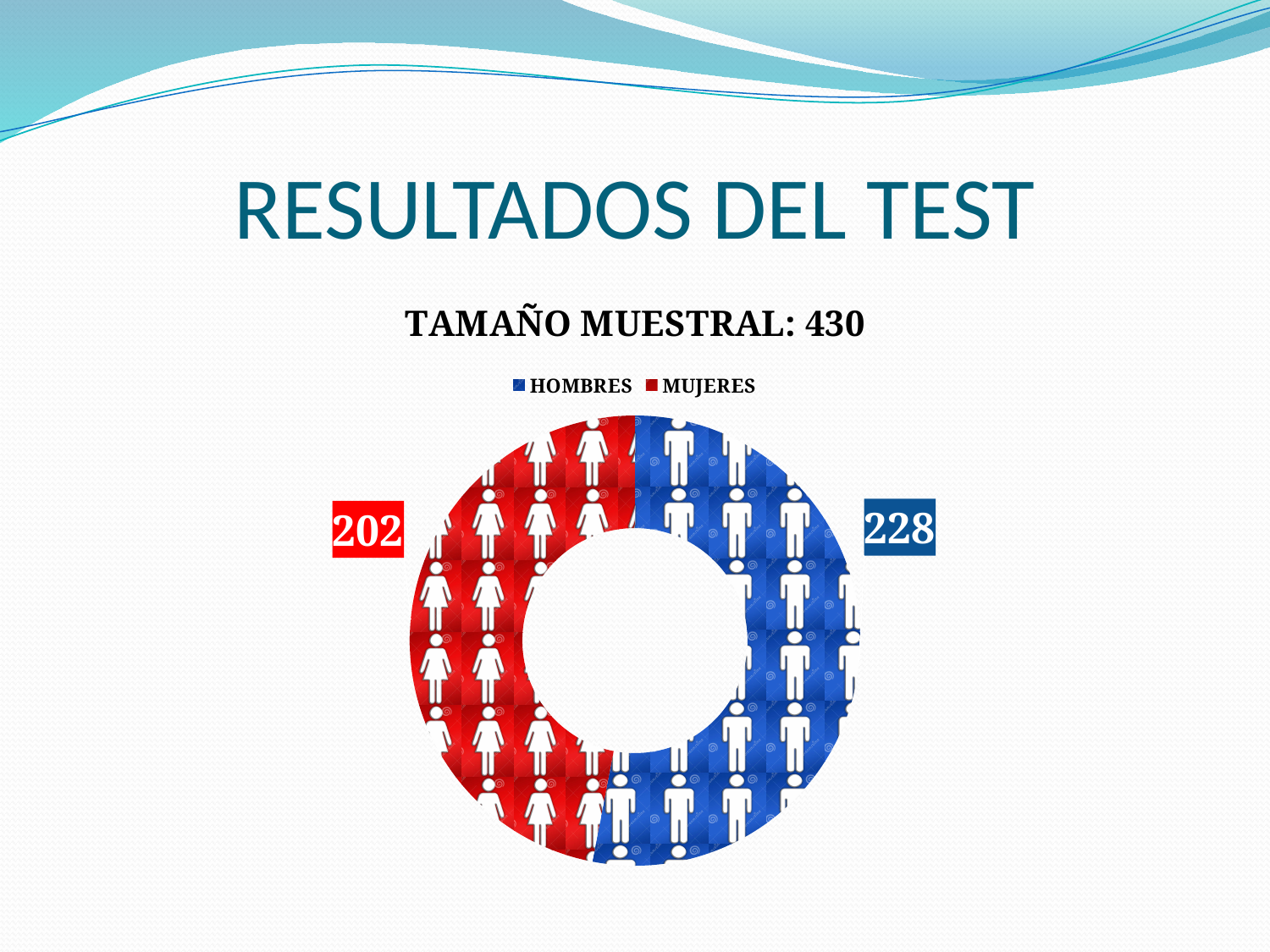
What is the title shown above the chart? TAMAÑO MUESTRAL: 430 Which category has the higher value, HOMBRES or MUJERES? HOMBRES How many entries does the legend list? 2 What is the value for MUJERES? 202 What is the total of the two values shown in the chart? 430 What is the value for HOMBRES? 228 Which category has the lowest value? MUJERES What is the difference between the values for HOMBRES and MUJERES? 26 How many categories does the chart show? 2 What kind of chart is shown on the slide? Doughnut (pie) chart Which category has the highest value? HOMBRES Which colour represents MUJERES in the chart? Red